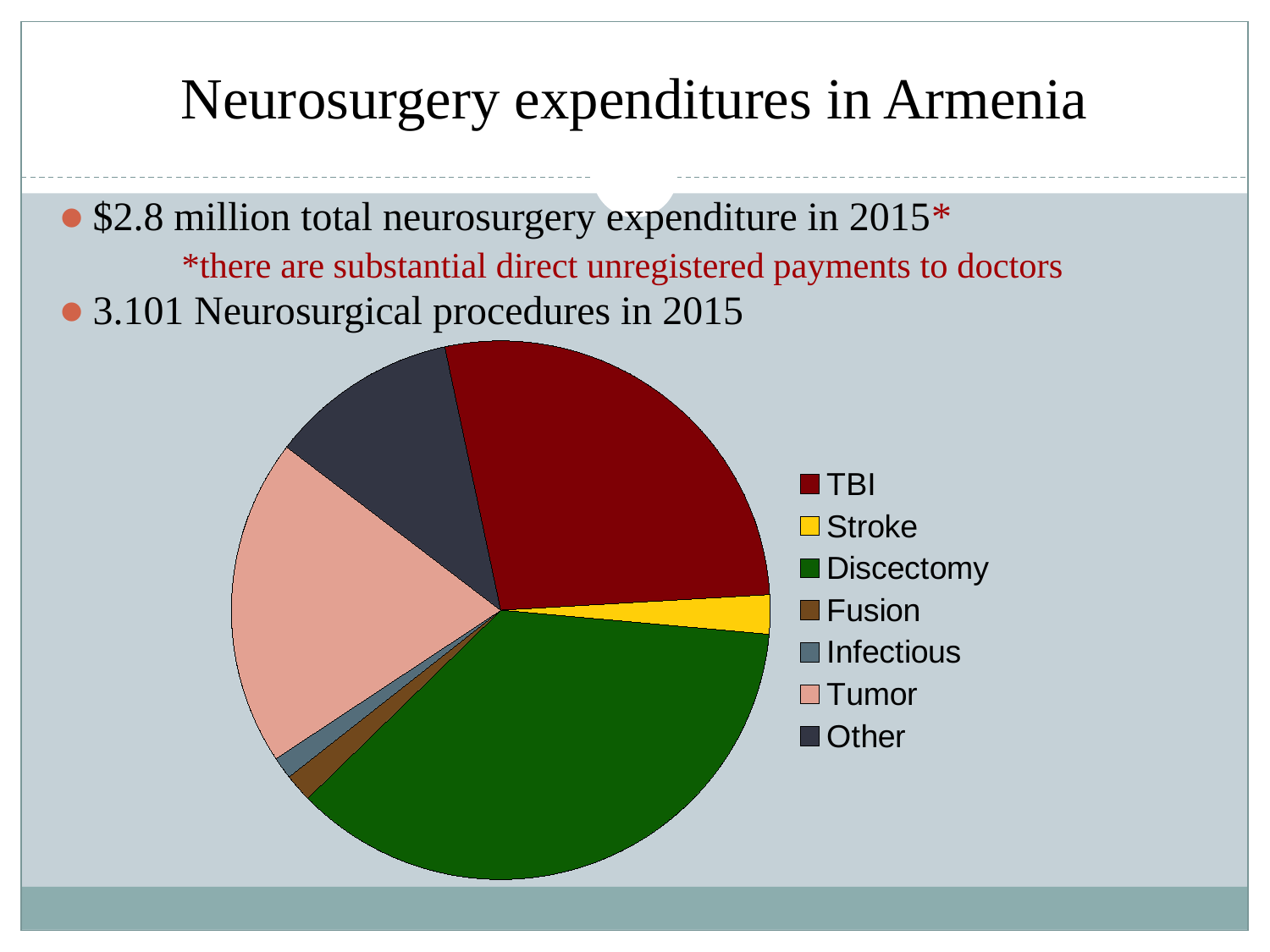
What kind of chart is shown on the slide? pie chart Which slice is larger, Tumor or Other? Tumor Which category has the largest slice of the pie chart? Discectomy Which slice is larger, TBI or Stroke? TBI Which category is listed first in the legend of the pie chart? TBI Which slice is larger, Stroke or Tumor? Tumor What colour is the TBI slice in the pie chart? dark red How many categories does the pie chart show? 7